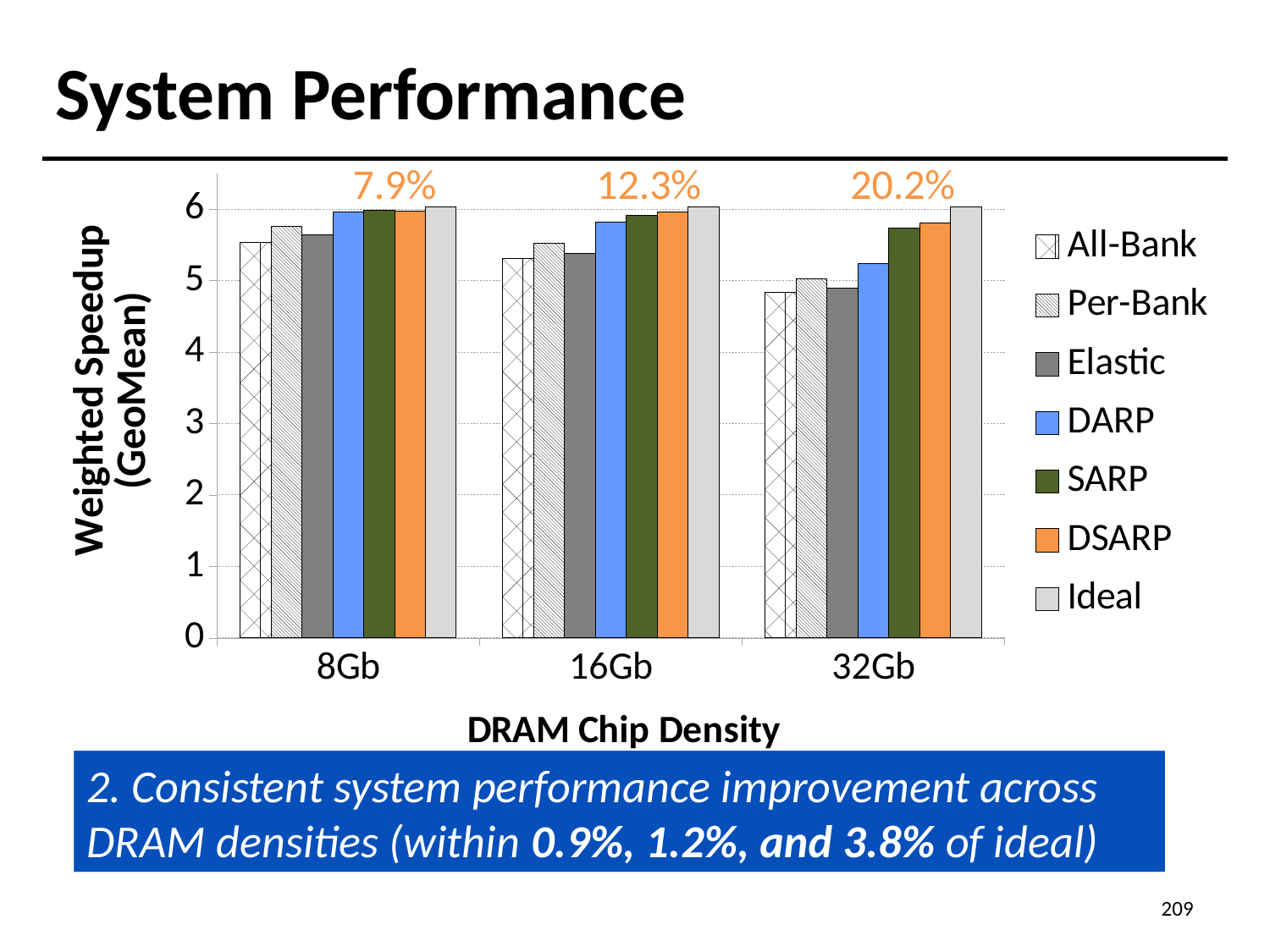
Is the value for All-Bank at 32Gb greater or less than 5? less Which series has the highest weighted speedup at 32Gb? Ideal How many DRAM chip density categories are shown on the x axis? 3 Is the value for Elastic at 16Gb greater or less than 5? greater At 32Gb, which is larger, DARP or Elastic? DARP Is the value for All-Bank at 8Gb greater or less than 5? greater Does the All-Bank weighted speedup rise or fall as DRAM chip density increases from 8Gb to 32Gb? fall What kind of chart is shown on the slide? bar chart At 32Gb, which is larger, the Ideal bar or the All-Bank bar? Ideal How many series does the legend list? 7 For the All-Bank series, at which DRAM chip density is the weighted speedup lowest? 32Gb